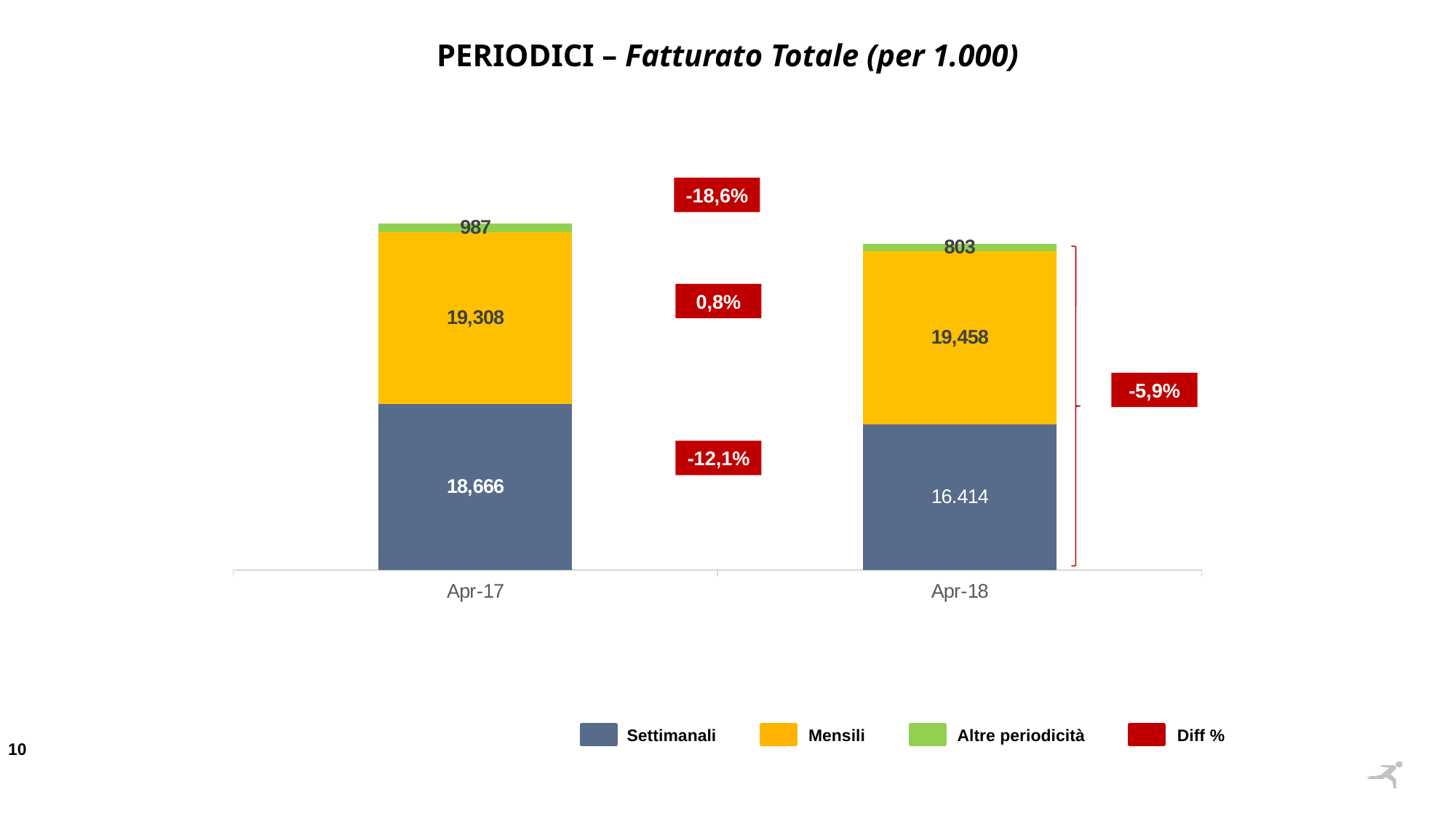
Which series has the largest value in Apr-18? Mensili How many entries does the legend list? 4 What is the value for Altre periodicità in Apr-17? 987 What is the value for Settimanali in Apr-18? 16.414 Is the Settimanali value larger in Apr-17 or Apr-18? Apr-17 What is the total of the stacked bar for Apr-17? 38,961 Which series has the smallest value in Apr-17? Altre periodicità What is the overall Diff % shown for the total between Apr-17 and Apr-18? -5,9% What percentage change is shown for Altre periodicità between Apr-17 and Apr-18? -18,6% What is the value for Settimanali in Apr-17? 18,666 What is the difference between the Mensili values for Apr-18 and Apr-17? 150 What is the value for Mensili in Apr-18? 19,458